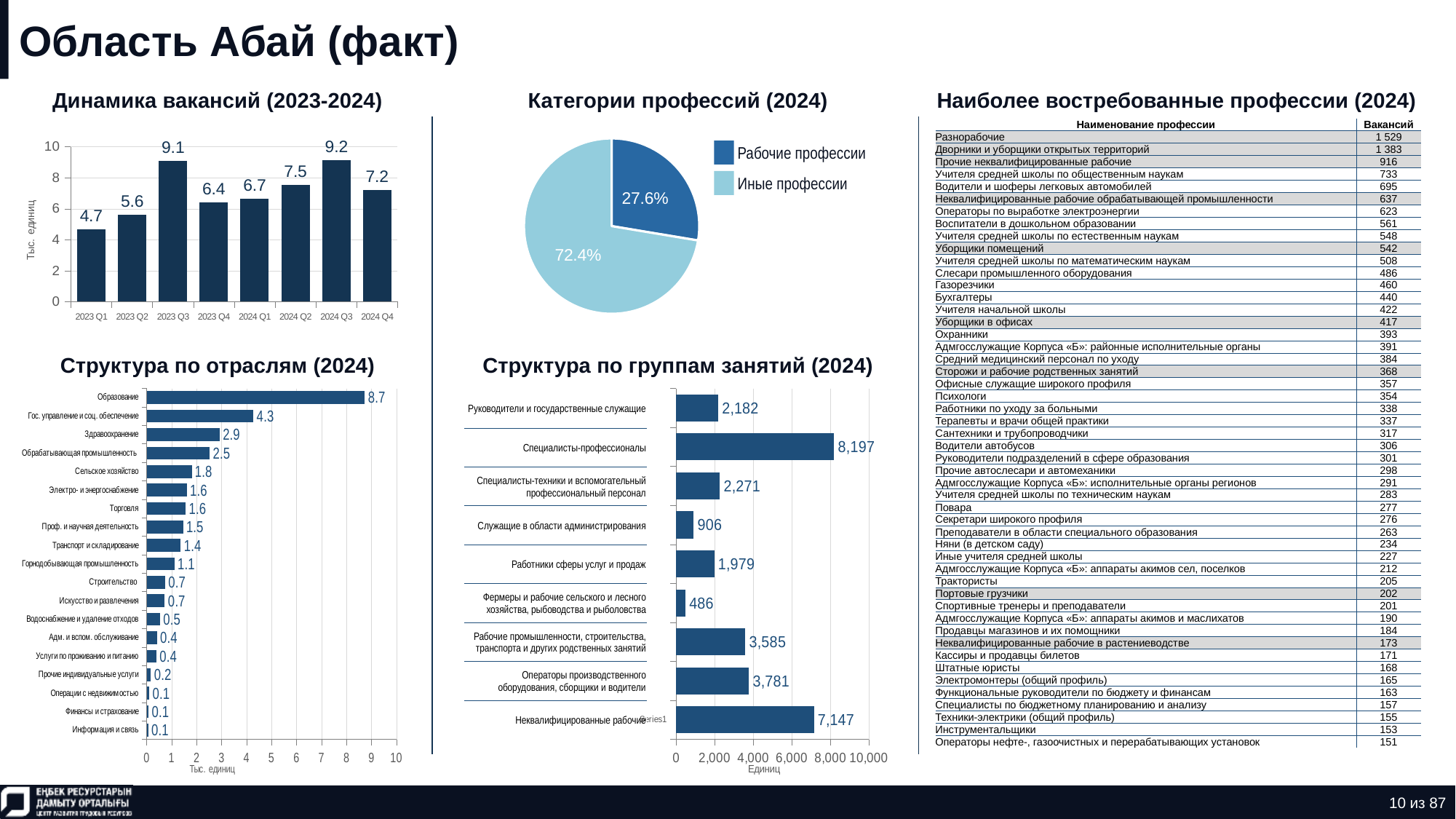
In the chart 'Динамика вакансий (2023-2024)', which quarter has the lowest value? 2023 Q1 In the chart 'Категории профессий (2024)', what share does 'Рабочие профессии' have? 27.6% In the chart 'Динамика вакансий (2023-2024)', what is the value for 2023 Q3? 9.1 In the chart 'Структура по отраслям (2024)', what is the value for 'Здравоохранение'? 2.9 In the chart 'Структура по отраслям (2024)', which category has the highest value? Образование What kind of chart is 'Категории профессий (2024)'? Pie chart In the chart 'Динамика вакансий (2023-2024)', what is the difference between the values for 2024 Q3 and 2024 Q4? 2.0 In the chart 'Структура по группам занятий (2024)', which category has the lowest value? Фермеры и рабочие сельского и лесного хозяйства, рыбоводства и рыболовства In the chart 'Структура по группам занятий (2024)', what is the value for 'Неквалифицированные рабочие'? 7,147 In the chart 'Динамика вакансий (2023-2024)', how many quarters are plotted? 8 In the chart 'Структура по группам занятий (2024)', which is larger: 'Руководители и государственные служащие' or 'Работники сферы услуг и продаж'? Руководители и государственные служащие In the chart 'Динамика вакансий (2023-2024)', which quarter has the highest value? 2024 Q3